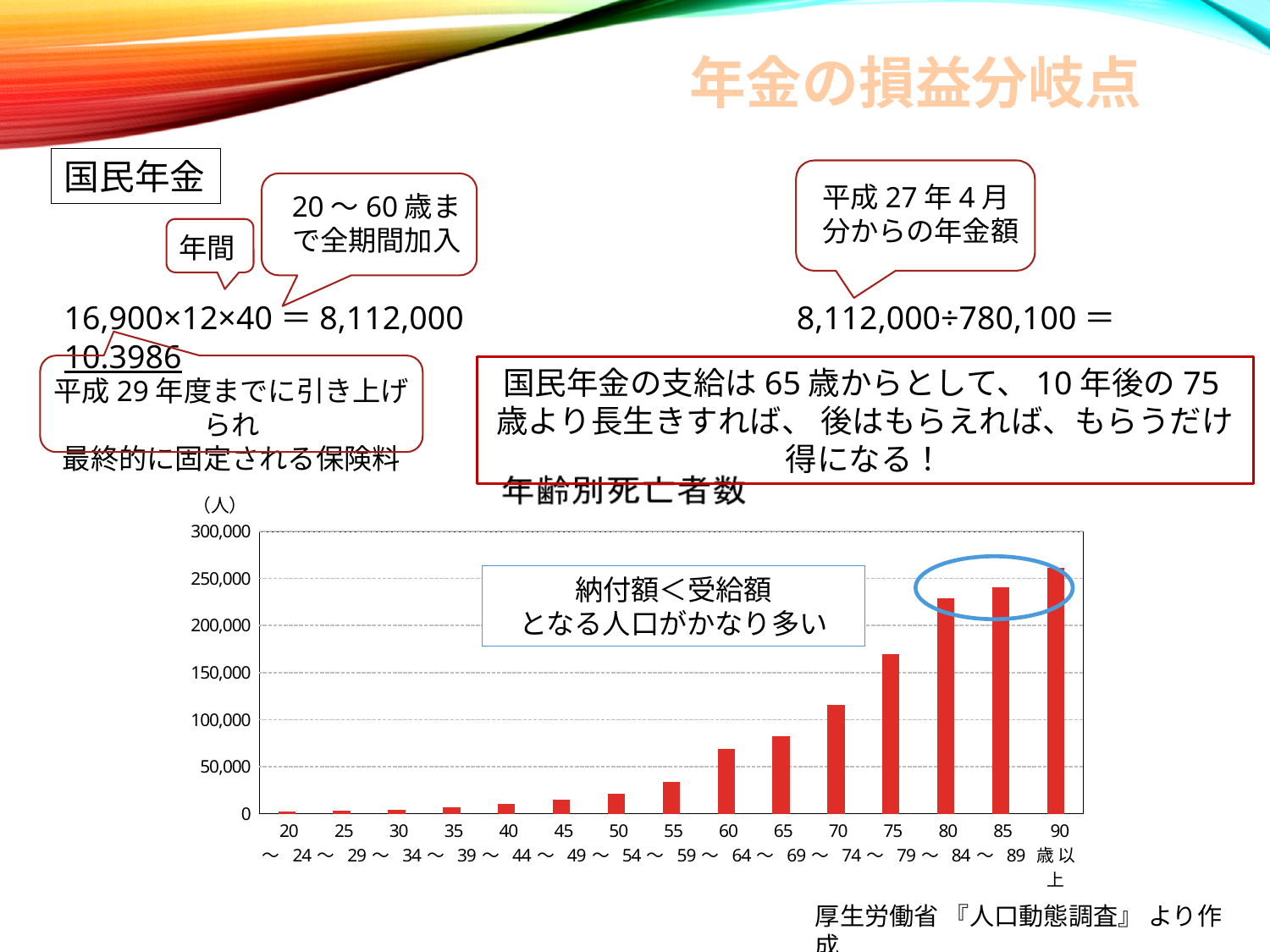
Is the value for 80～84 greater or less than 200,000? greater Which age group has the highest number of deaths? 90歳以上 Do the values generally rise or fall as age increases along the x axis? Rise Is the value for 70～74 greater or less than 100,000? greater What is the title of the chart? 年齢別死亡者数 Which is larger, the value for 85～89 or the value for 75～79? 85～89 Is the value for 75～79 greater or less than 150,000? greater How many age-group categories are plotted on the x axis? 15 What kind of chart is shown on the slide? Bar chart What unit is shown at the top of the y axis? （人）